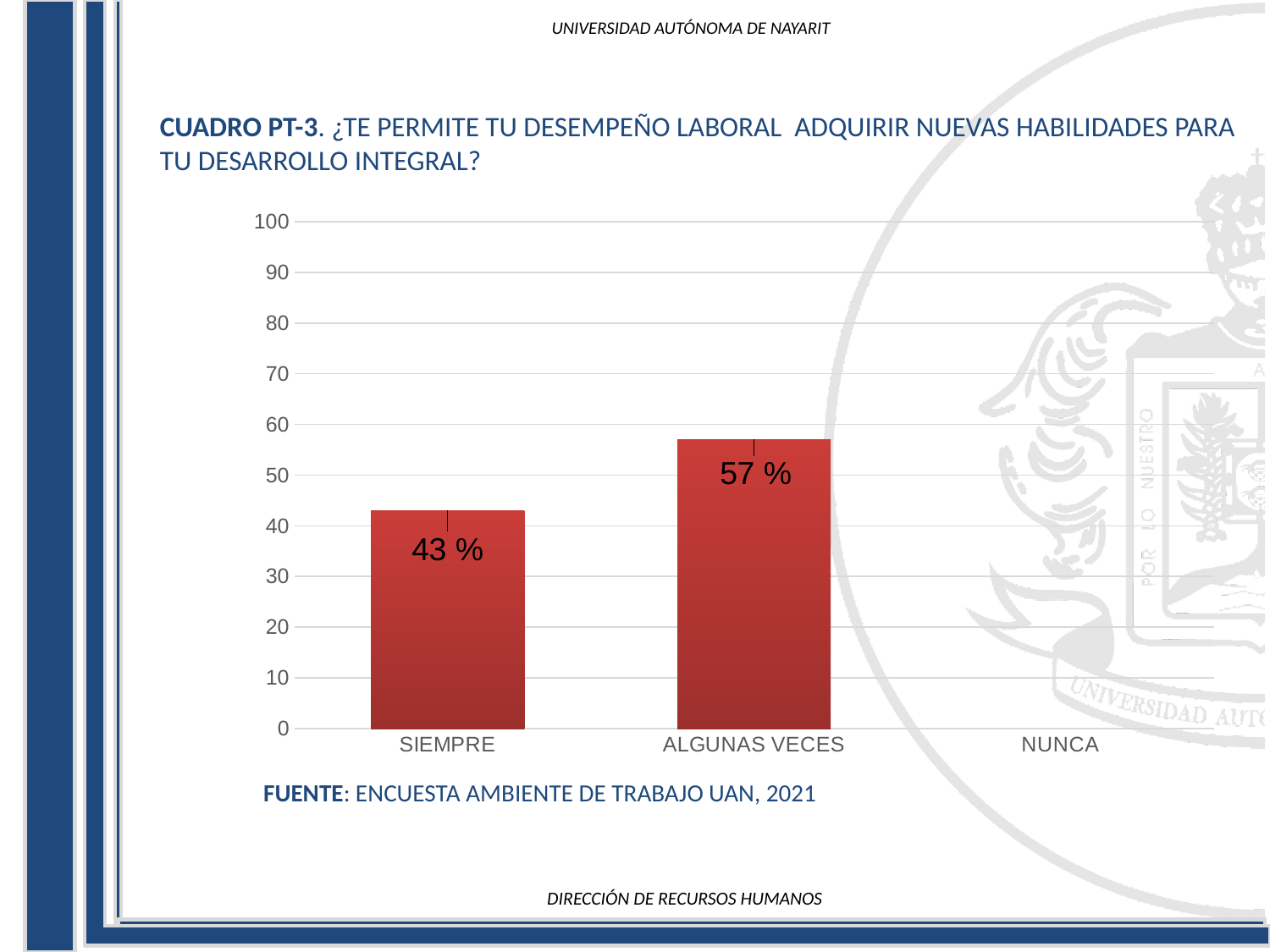
Which is larger, the value for SIEMPRE or the value for ALGUNAS VECES? ALGUNAS VECES Which category has the highest value? ALGUNAS VECES What kind of chart is shown on the slide? bar chart Is the value for SIEMPRE greater or less than 50? less Is the value for ALGUNAS VECES greater or less than 50? greater What is the value for ALGUNAS VECES? 57 % How many categories are shown on the x axis? 3 What is the maximum value shown on the y axis? 100 What source is cited below the chart? ENCUESTA AMBIENTE DE TRABAJO UAN, 2021 What is the value for SIEMPRE? 43 % What is the difference between the values for ALGUNAS VECES and SIEMPRE? 14 %